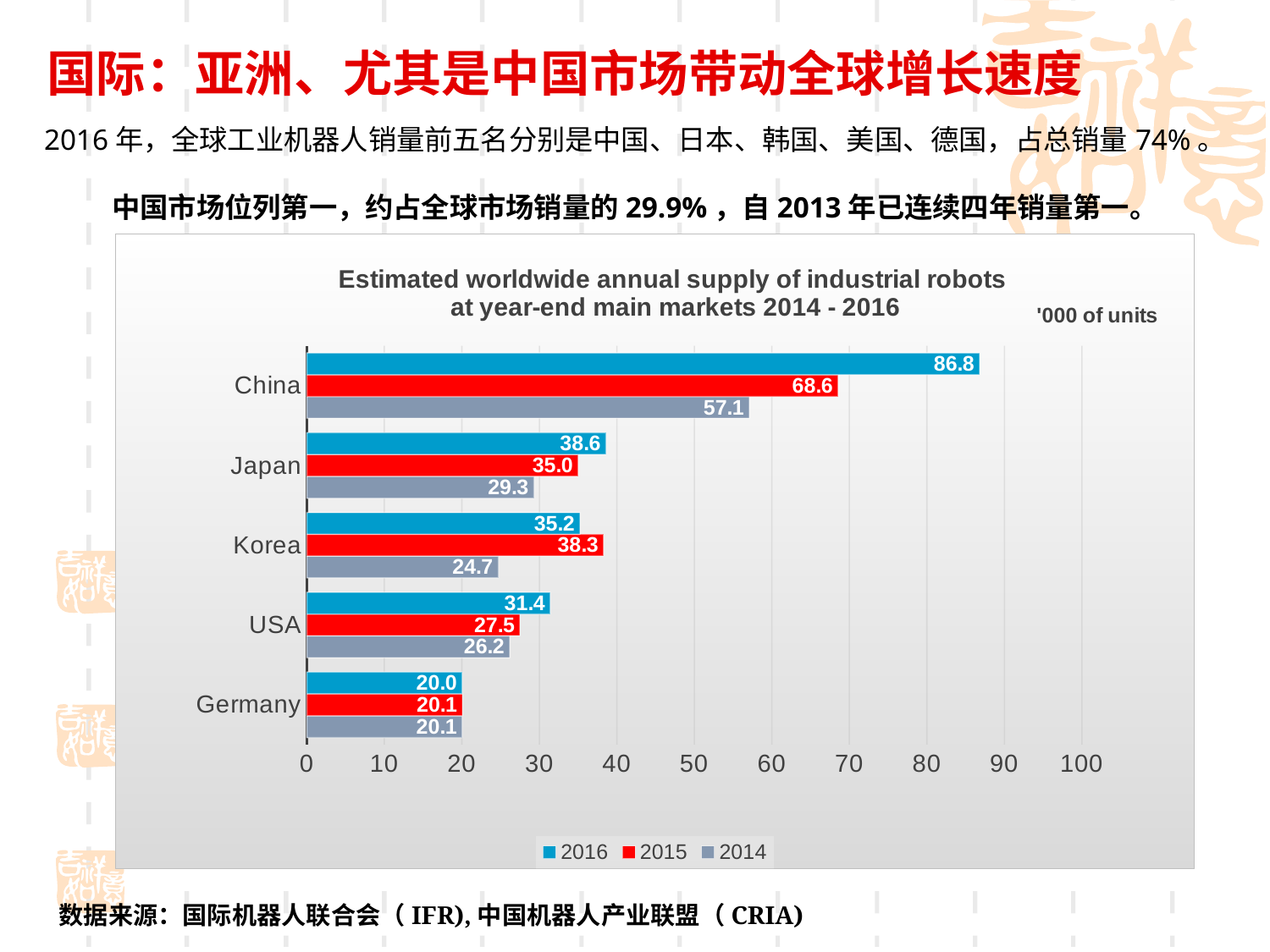
Is the 2014 value for China greater or less than 50? greater What is the 2014 value for Korea? 24.7 What unit is indicated at the top right of the chart? '000 of units What is the 2016 value for China? 86.8 How many countries are shown on the chart? 5 What is the 2015 value for USA? 27.5 How many series does the legend list? 3 Which country has the highest 2016 value? China Which country has the lowest 2014 value? Germany What is the difference between China's 2016 and 2015 values? 18.2 What kind of chart is shown? bar chart Which is larger for Korea, the 2016 value or the 2015 value? 2015